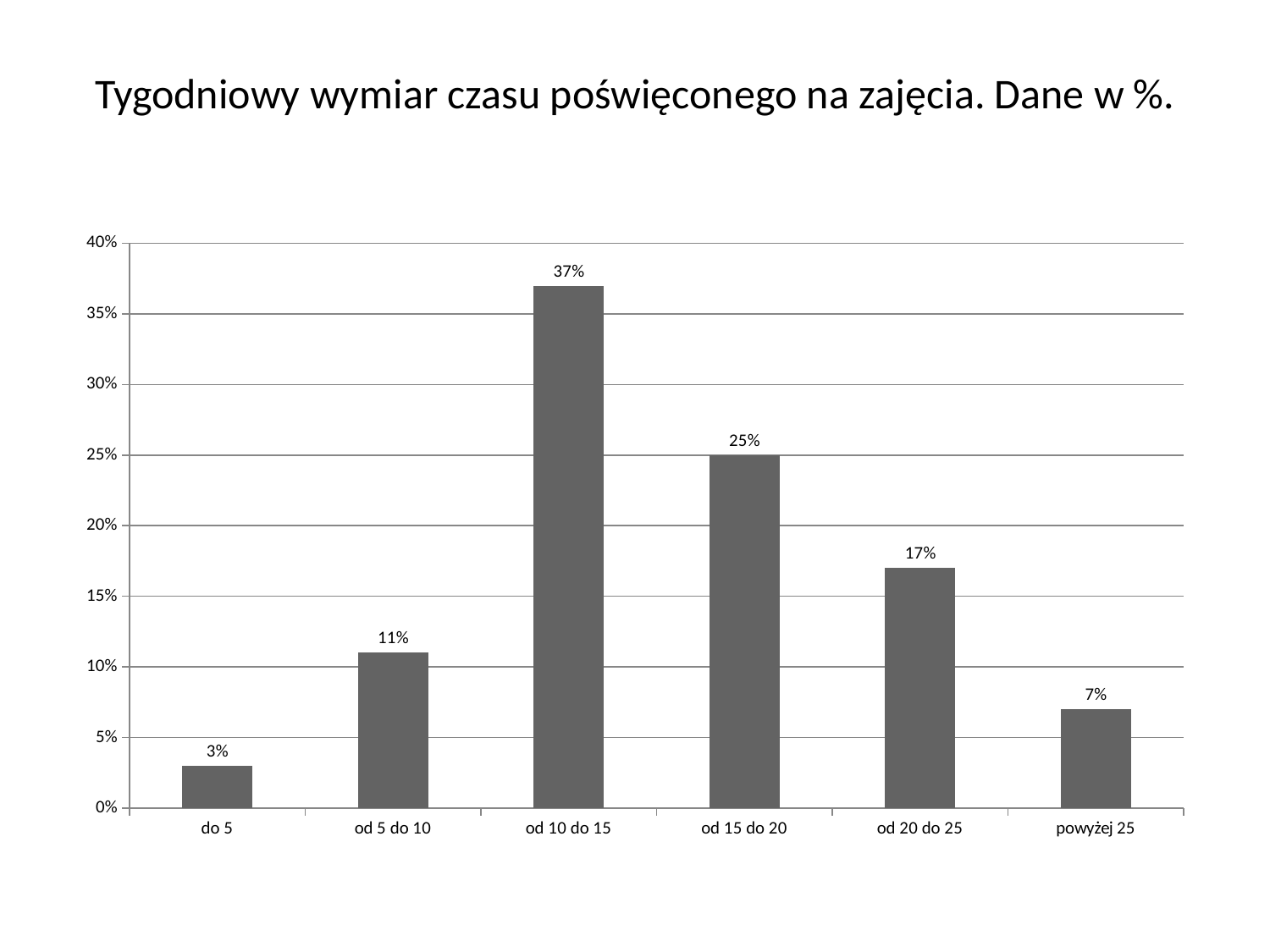
Which category has the lowest value? do 5 Is the value for "od 15 do 20" greater or less than 20%? greater How many categories are shown on the x axis? 6 What is the value for the category "do 5"? 3% What is the value for the category "powyżej 25"? 7% What is the difference between the values for "od 10 do 15" and "od 15 do 20"? 12% What is the value for the category "od 10 do 15"? 37% What is the difference between the values for "od 20 do 25" and "powyżej 25"? 10% Which is larger, the value for "od 5 do 10" or the value for "od 20 do 25"? od 20 do 25 What is the title of the chart on the slide? Tygodniowy wymiar czasu poświęconego na zajęcia. Dane w %. Which category has the highest value? od 10 do 15 What kind of chart is shown on the slide? bar chart